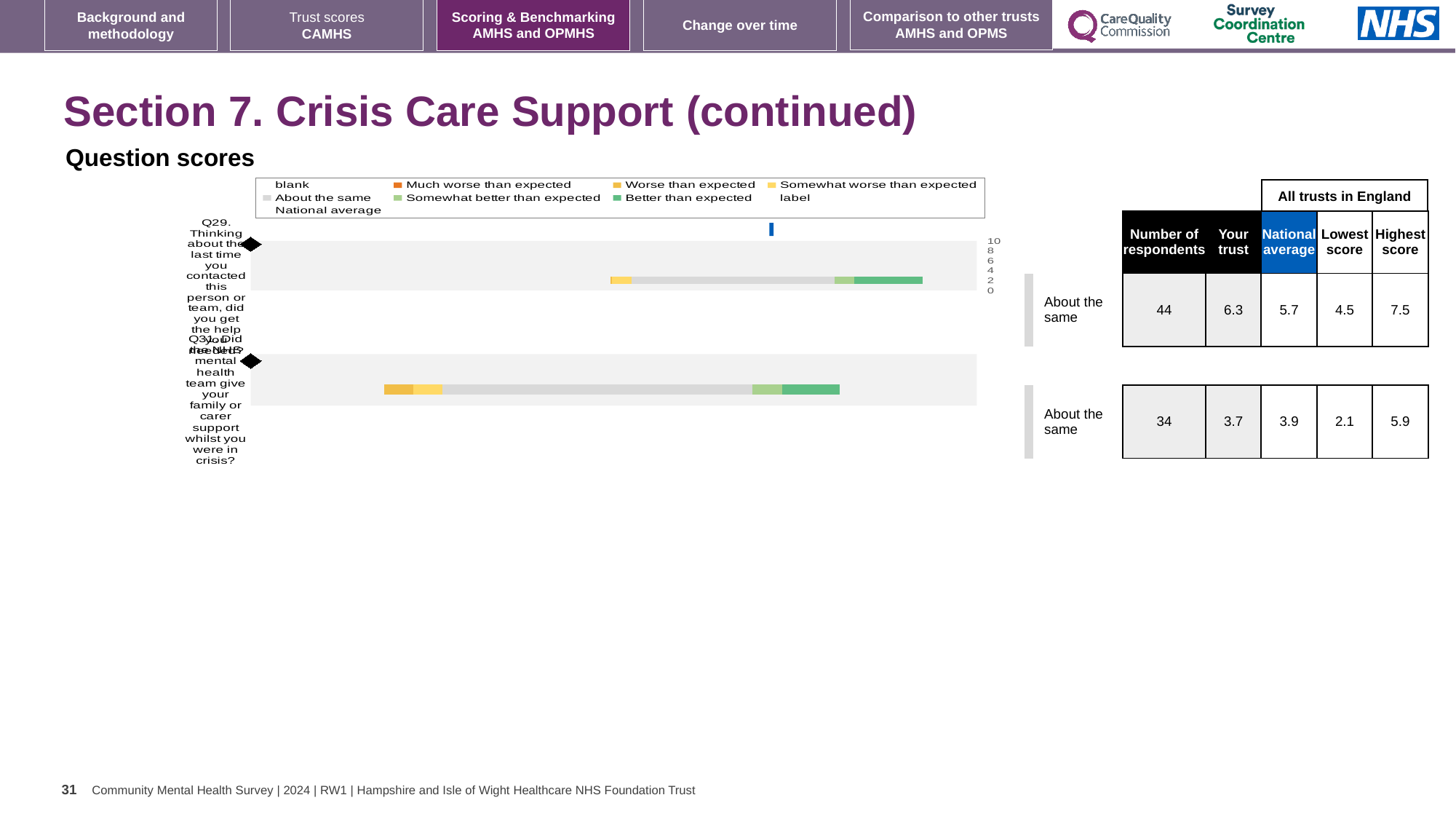
What is the 'Your trust' score for Q29? 6.3 What is the difference between the highest and lowest scores for Q29? 3.0 What is the national average score for Q31? 3.9 What is the difference between the national average and the 'Your trust' score for Q31? 0.2 What kind of chart is shown under 'Question scores'? bar chart What is the highest score among all trusts in England for Q29? 7.5 What benchmark category is shown next to both Q29 and Q31? About the same For Q29, which is larger: the 'Your trust' score or the national average? Your trust How many entries does the chart legend list? 9 How many respondents answered Q31? 34 Which question has the higher 'Your trust' score, Q29 or Q31? Q29 How many questions (bars) are plotted in the chart? 2